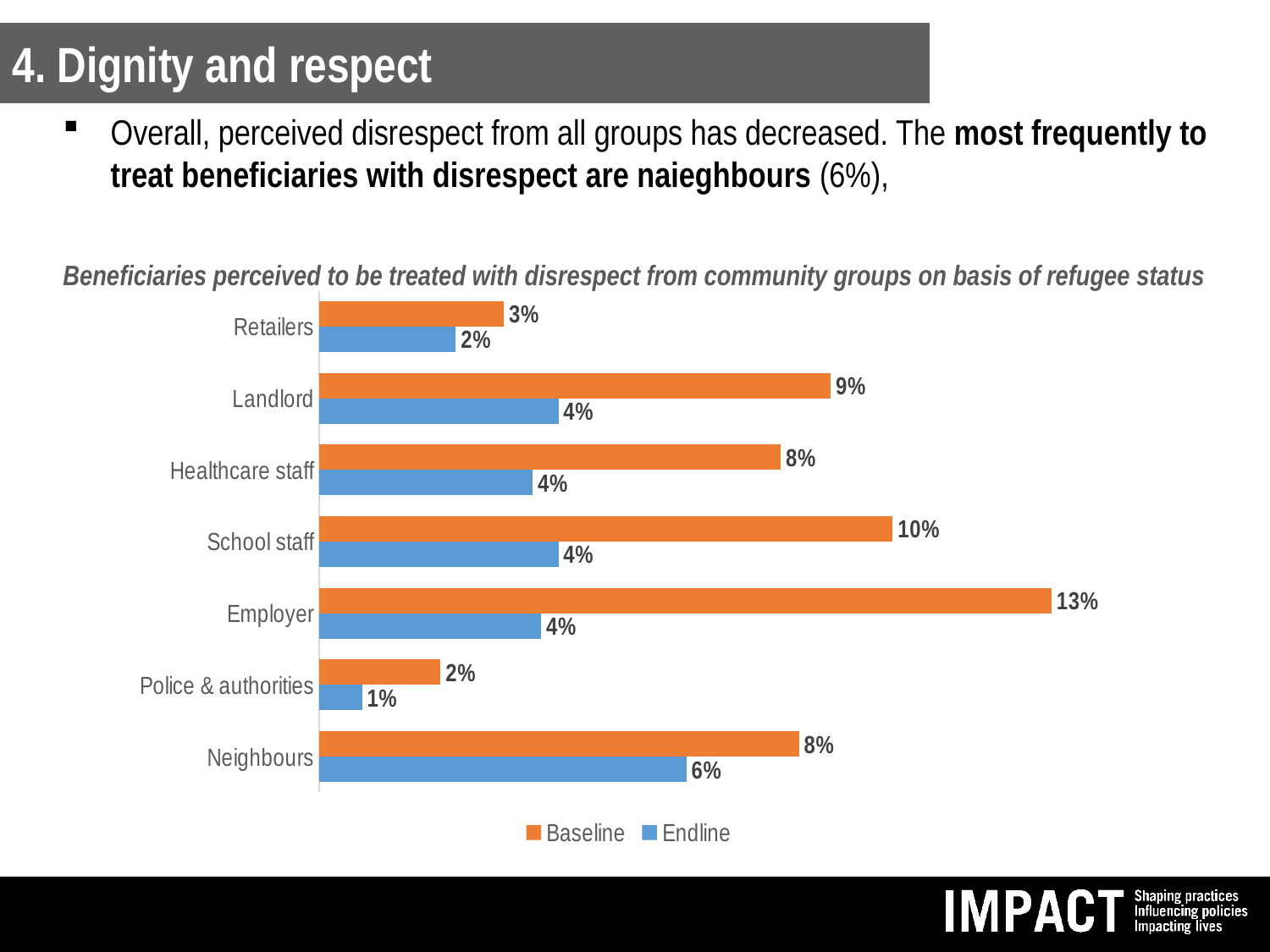
Which category has the highest Baseline value? Employer What is the Endline value for Police & authorities? 1% How many categories are shown on the chart? 7 Which is larger, the Baseline value for School staff or the Baseline value for Healthcare staff? School staff What is the Endline value for Neighbours? 6% What is the Baseline value for Employer? 13% Which category has the lowest Endline value? Police & authorities What kind of chart is shown on the slide? Bar chart What is the Baseline value for Landlord? 9% How many series does the legend list? 2 Which colour represents the Endline series? Blue What is the difference between the Baseline and Endline values for Employer? 9%